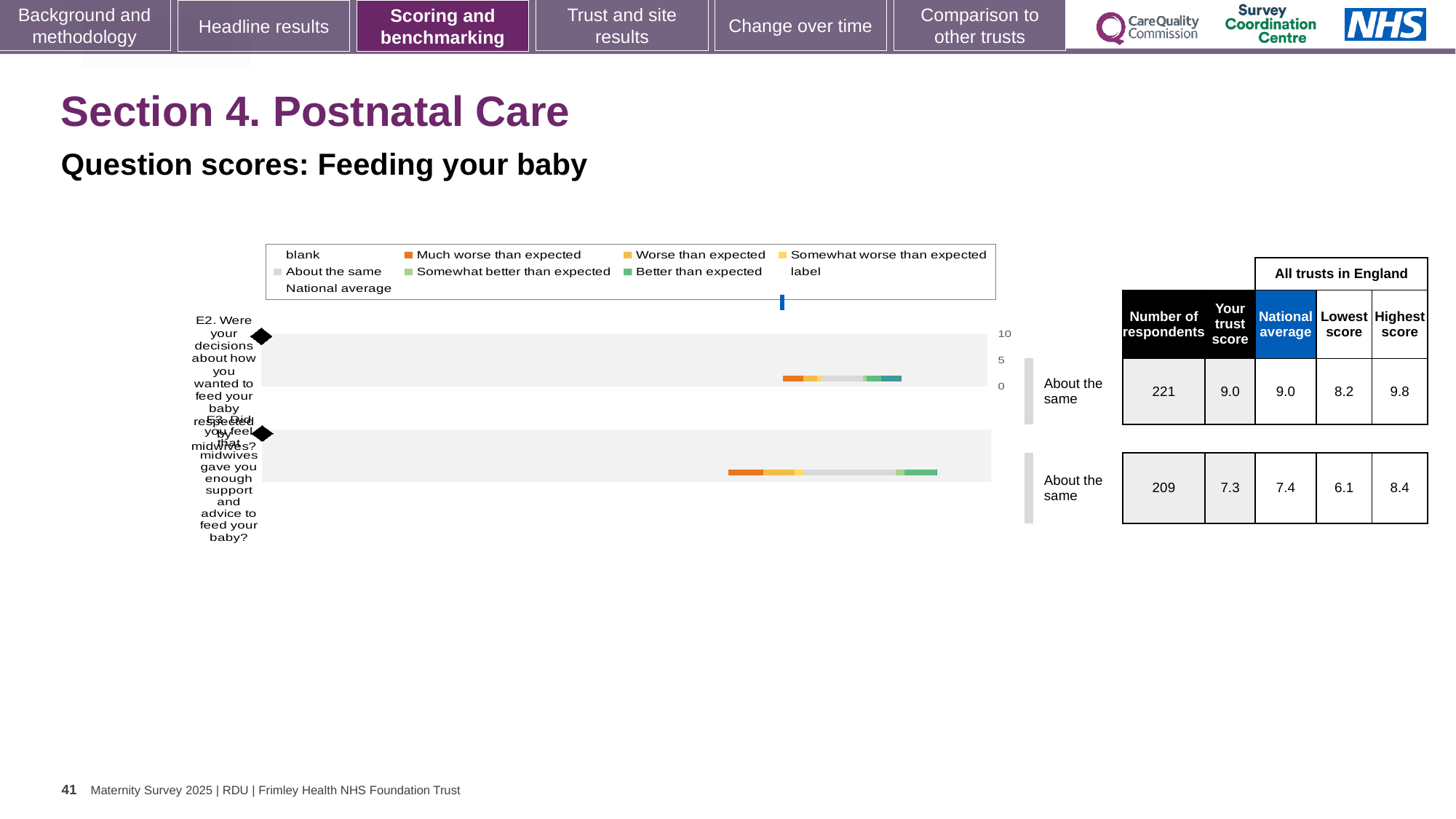
Which question has the higher trust score, E2 or E3? E2 What is the difference between the highest and lowest scores for E3 across all trusts in England? 2.3 What is the highest score among all trusts in England for E2? 9.8 What benchmark category is shown for both E2 and E3? About the same How many entries does the legend of the Feeding your baby chart list? 9 What is the national average score for E3? 7.4 What is the trust score for E3 (midwives gave you enough support and advice to feed your baby)? 7.3 What kind of chart is used to show the question scores for Feeding your baby? bar chart Which colour represents 'Much worse than expected' in the legend? orange How many respondents answered question E2? 221 How many questions (categories) are plotted in the Feeding your baby chart? 2 What is the trust score for E2 (decisions about how you wanted to feed your baby respected by midwives)? 9.0